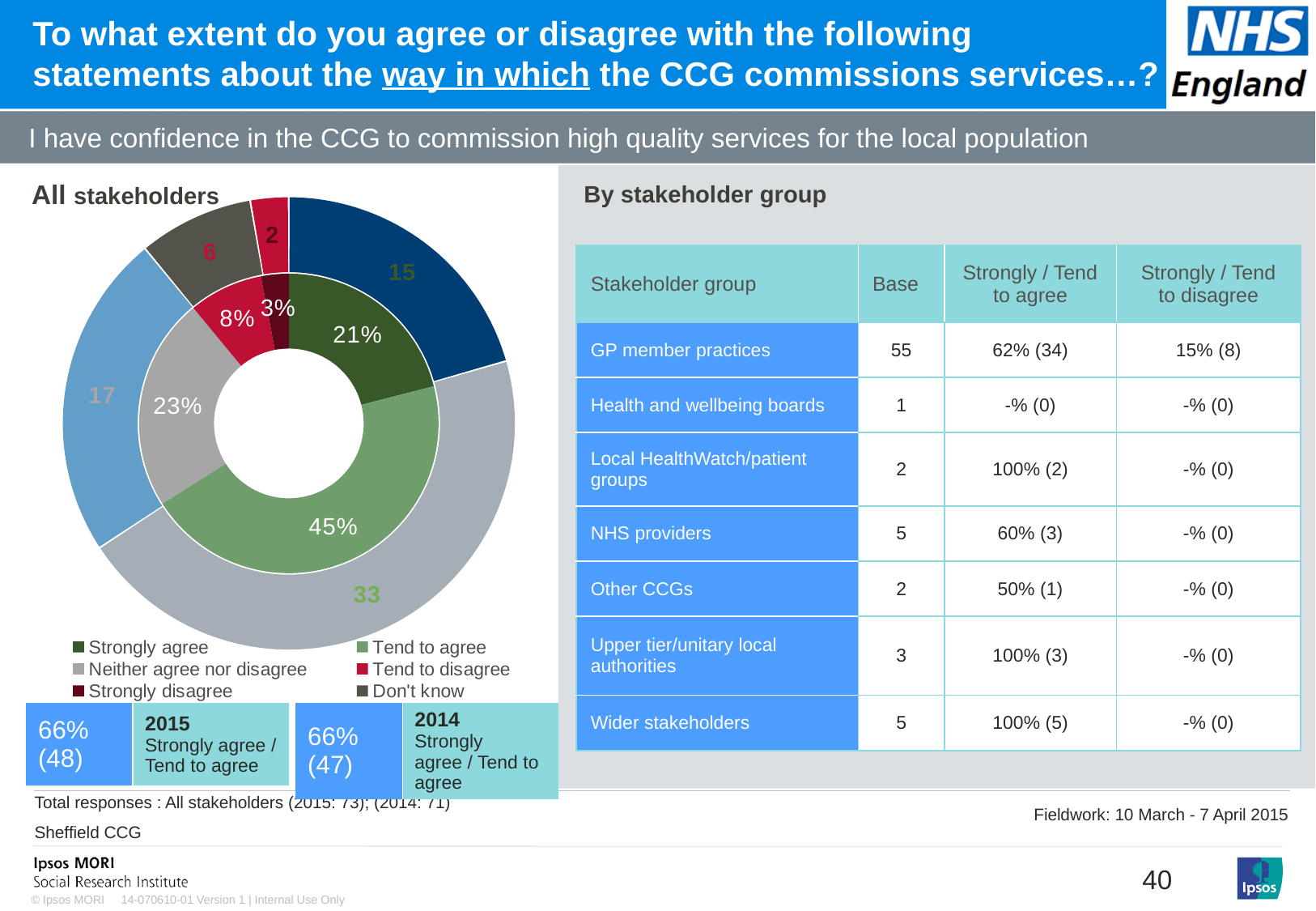
In the 'All stakeholders' chart, what percentage is shown for 'Strongly disagree'? 3% In the 'All stakeholders' chart, what percentage is shown for 'Tend to disagree'? 8% In the 'All stakeholders' chart, which is larger: 'Neither agree nor disagree' or 'Strongly agree'? Neither agree nor disagree How many response categories does the legend of the 'All stakeholders' chart list? 6 In the 'All stakeholders' chart, what is the difference in percentage points between 'Tend to agree' and 'Strongly agree'? 24 percentage points In the 'All stakeholders' chart, what percentage is shown for 'Neither agree nor disagree'? 23% In the 'All stakeholders' chart, which labelled response category has the smallest share? Strongly disagree What type of chart is shown under 'All stakeholders'? Donut (pie) chart In the 'All stakeholders' chart, which response category has the largest share? Tend to agree In the 'All stakeholders' chart, what percentage is shown for 'Strongly agree'? 21% In the 'All stakeholders' chart, what percentage is shown for 'Tend to agree'? 45% In the 'All stakeholders' chart, what colour represents 'Tend to disagree' in the legend? Red